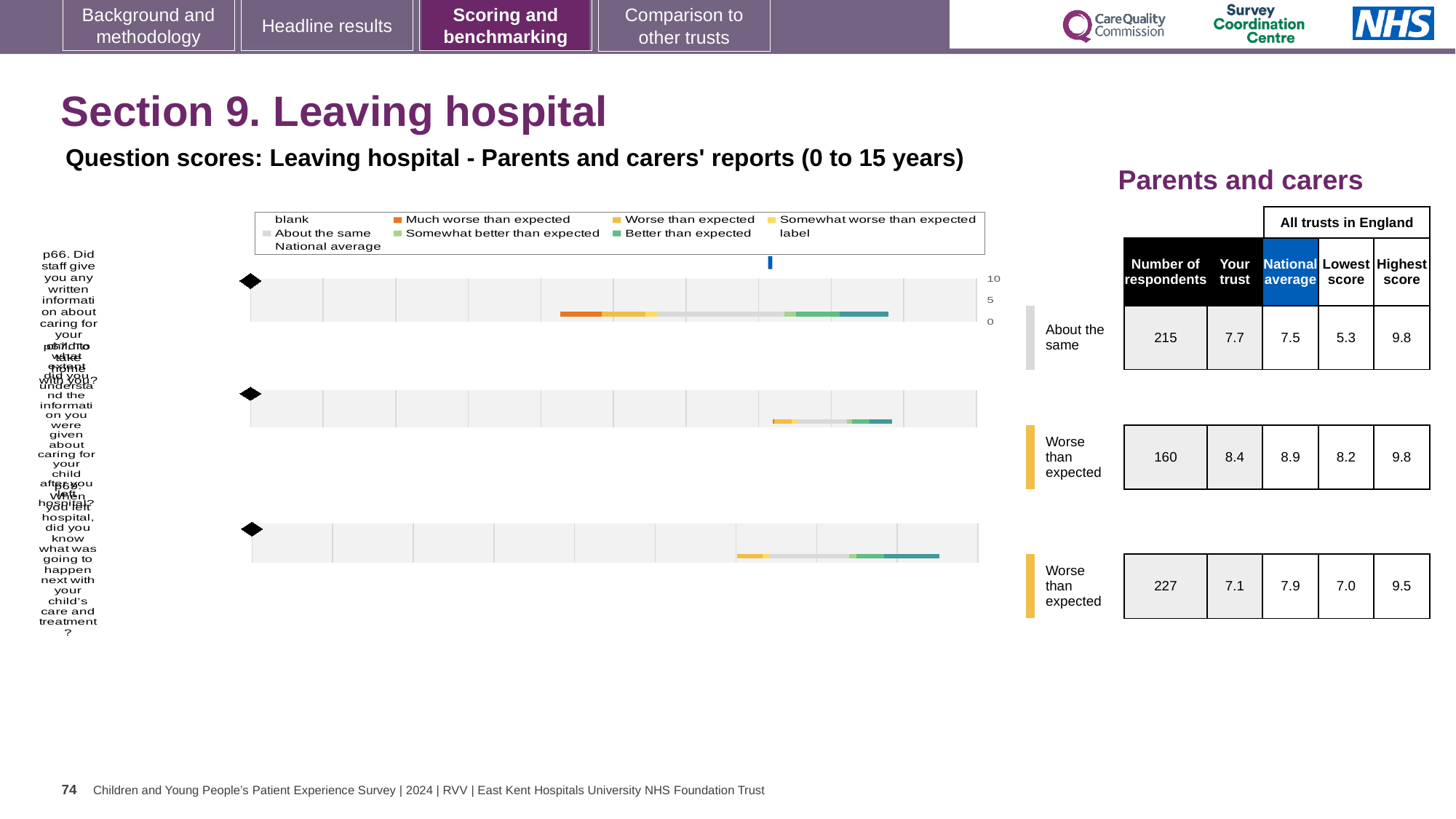
For the middle row, what is the difference between the national average (8.9) and the 'Your trust' score (8.4)? 0.5 How many question rows (bars) are plotted on the slide? 3 In the chart legend, what does the blue marker represent? National average In the table beside the charts, what is the 'Your trust' score for the top row (rated 'About the same')? 7.7 In the table beside the charts, what is the highest score for the bottom row? 9.5 In the table beside the charts, what is the national average for the middle row? 8.9 In the table beside the charts, what is the number of respondents for the top row (rated 'About the same')? 215 For the top row, which is larger: the 'Your trust' score or the national average? Your trust What kind of chart is used to show the question scores on this slide? bar chart In the chart legend, what colour is used for 'Much worse than expected'? orange In the table beside the charts, what is the lowest score for the middle row? 8.2 Which row has the highest number of respondents in the table? the bottom row (227)